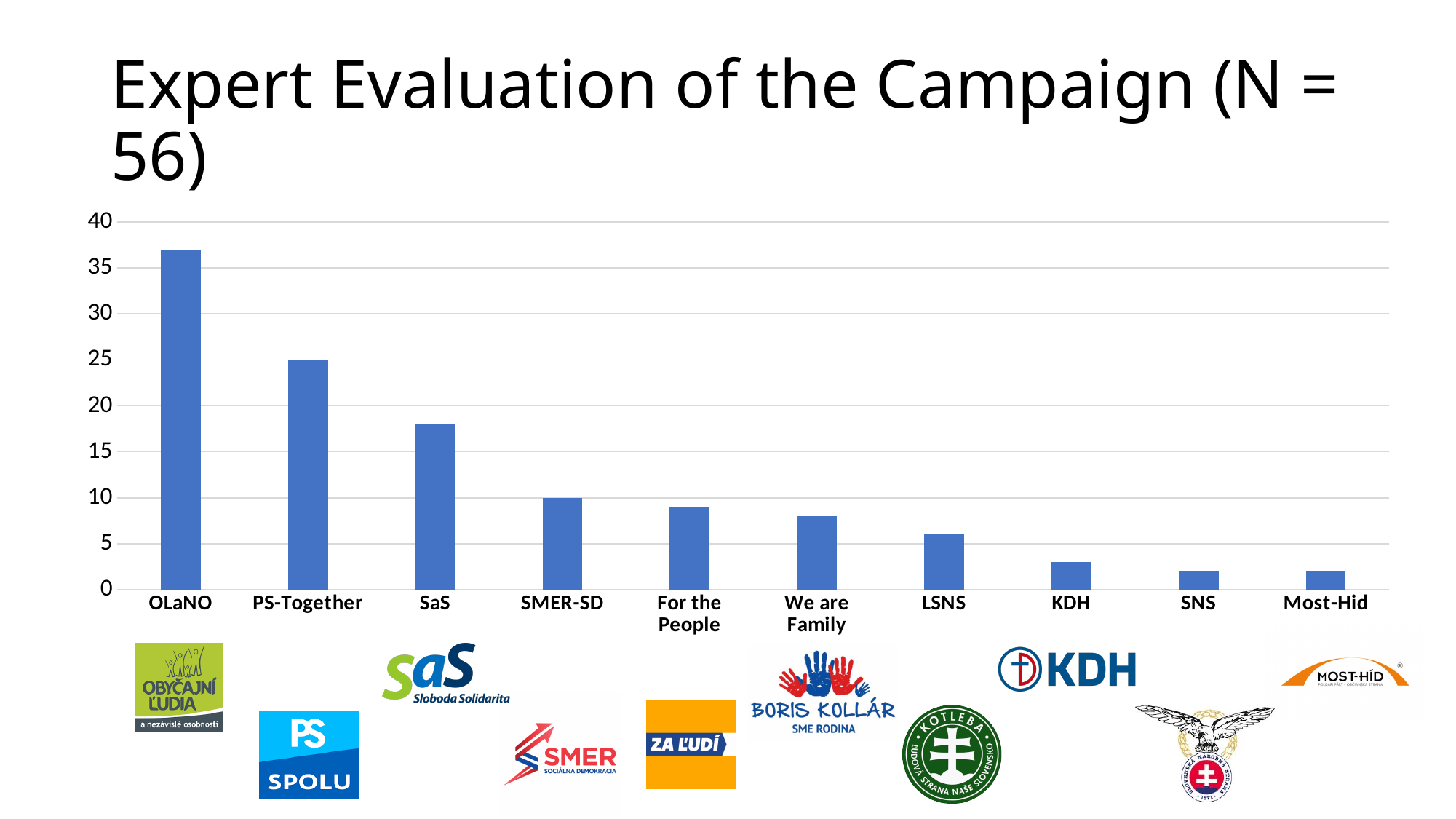
What is the title of the chart on the slide? Expert Evaluation of the Campaign (N = 56) Is the value for LSNS greater or less than 5? greater What kind of chart is shown on the slide? bar chart Is the value for OLaNO greater or less than 35? greater Which party has the highest value in the chart? OLaNO Which has a larger value, LSNS or KDH? LSNS Is the value for We are Family greater or less than 10? less How many parties (categories) are shown on the x axis of the chart? 10 Do the values generally rise or fall moving from left to right along the x axis? fall Which has a larger value, SaS or SMER-SD? SaS